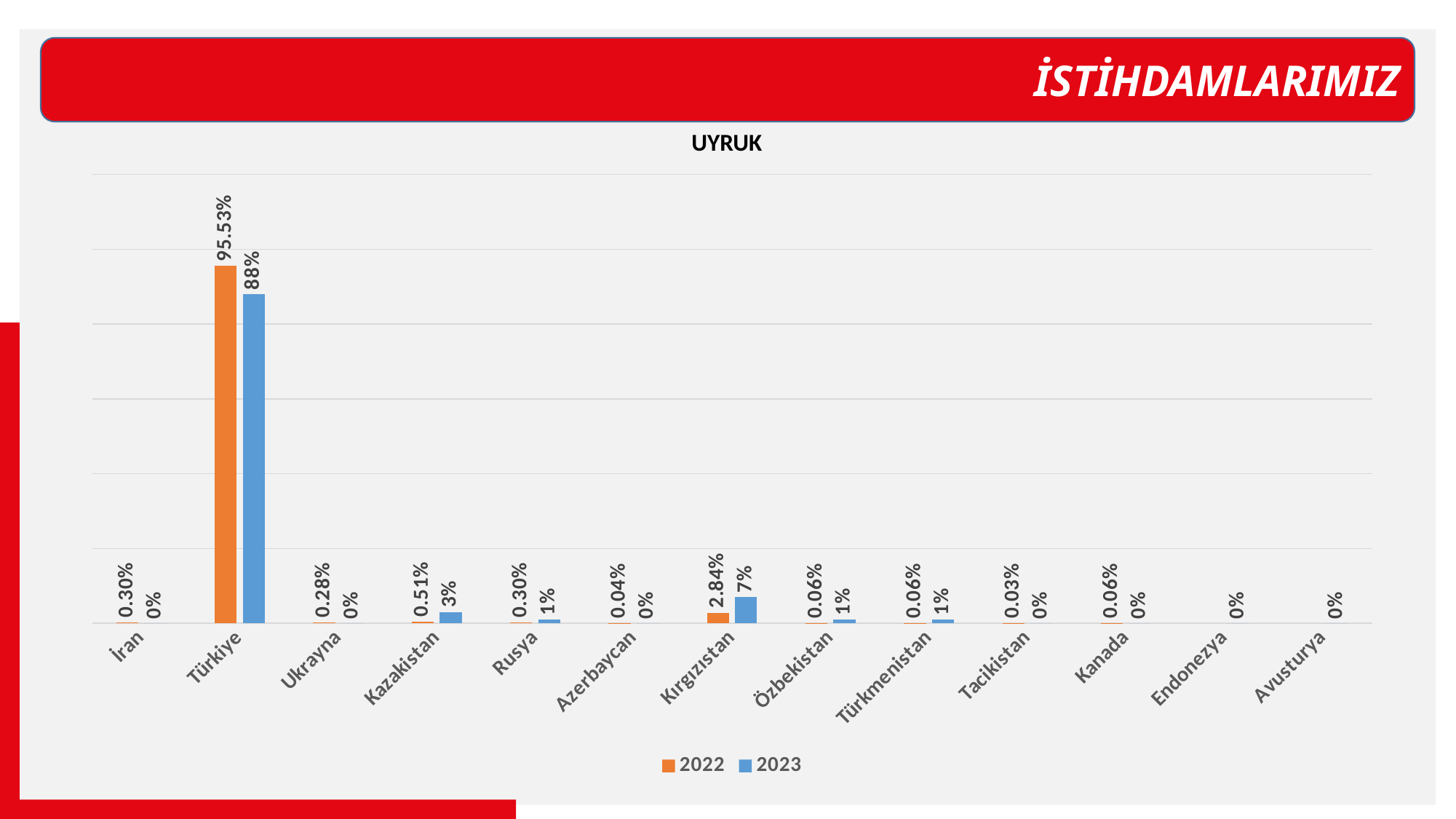
What is the difference between the 2022 and 2023 values for Türkiye? 7.53% What is the 2022 value for Kazakistan? 0.51% What is the title of the chart? UYRUK What is the 2023 value for Kazakistan? 3% How many categories are shown on the x axis? 13 How many series does the legend list? 2 Which category has the highest 2023 value? Türkiye Which is larger for Kırgızistan, the 2022 value or the 2023 value? 2023 What is the 2023 value for Kırgızistan? 7% What is the 2022 value for Türkiye? 95.53% What kind of chart is shown? Bar chart Which category has the highest 2022 value? Türkiye